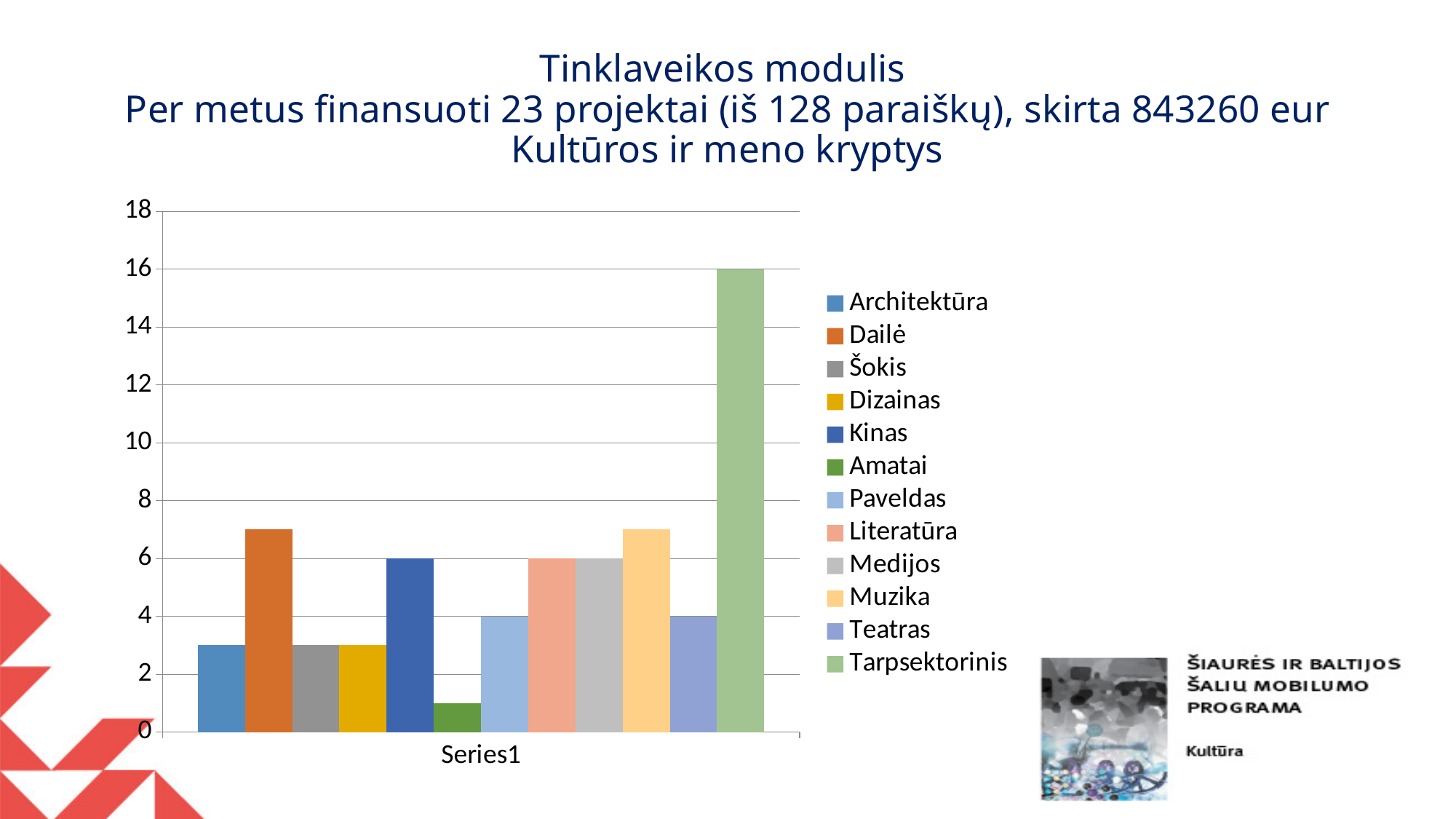
Which series has the lowest bar? Amatai Which series has the highest bar? Tarpsektorinis How many series does the legend list? 12 What is the value for Kinas? 6 Is the value for Amatai greater or less than 2? less What is the value for Tarpsektorinis? 16 Is the value for Dailė greater or less than 6? greater What is the label shown on the x axis under the bars? Series1 What type of chart is shown on the slide? bar chart Which is larger, the value for Kinas or the value for Teatras? Kinas What is the value for Paveldas? 4 What is the difference between the values for Tarpsektorinis and Kinas? 10